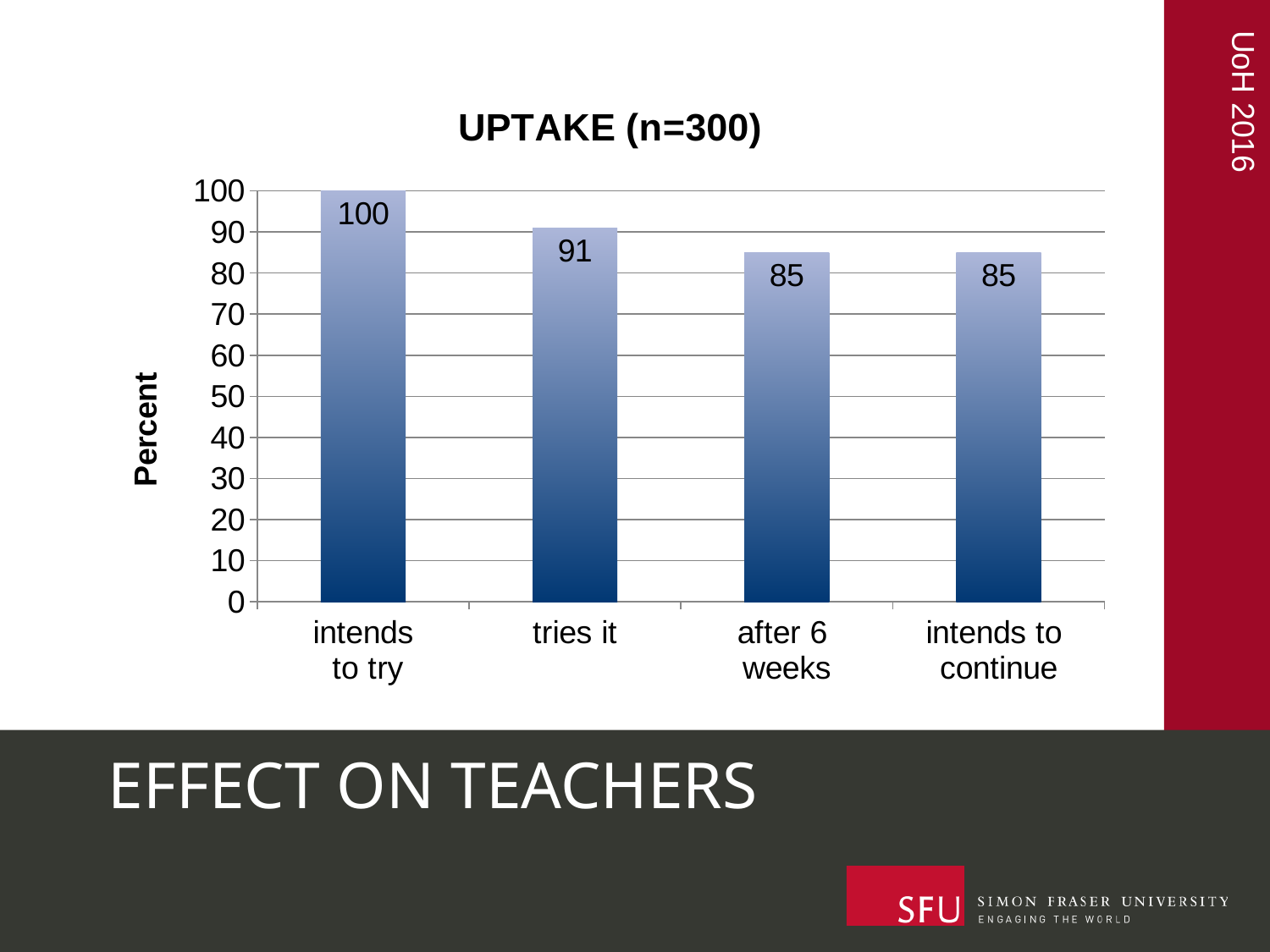
Which is larger, the value for "intends to try" or the value for "after 6 weeks"? intends to try Is the value for "tries it" greater or less than 80? greater What kind of chart is shown on the slide? bar chart What is the value for "after 6 weeks"? 85 How many categories are shown on the x axis? 4 What is the difference between the values for "tries it" and "after 6 weeks"? 6 What is the value for "intends to try"? 100 What is the title of the chart? UPTAKE (n=300) What is the value for "intends to continue"? 85 What is the value for "tries it"? 91 What is the difference between the values for "intends to try" and "tries it"? 9 Which category has the highest value? intends to try